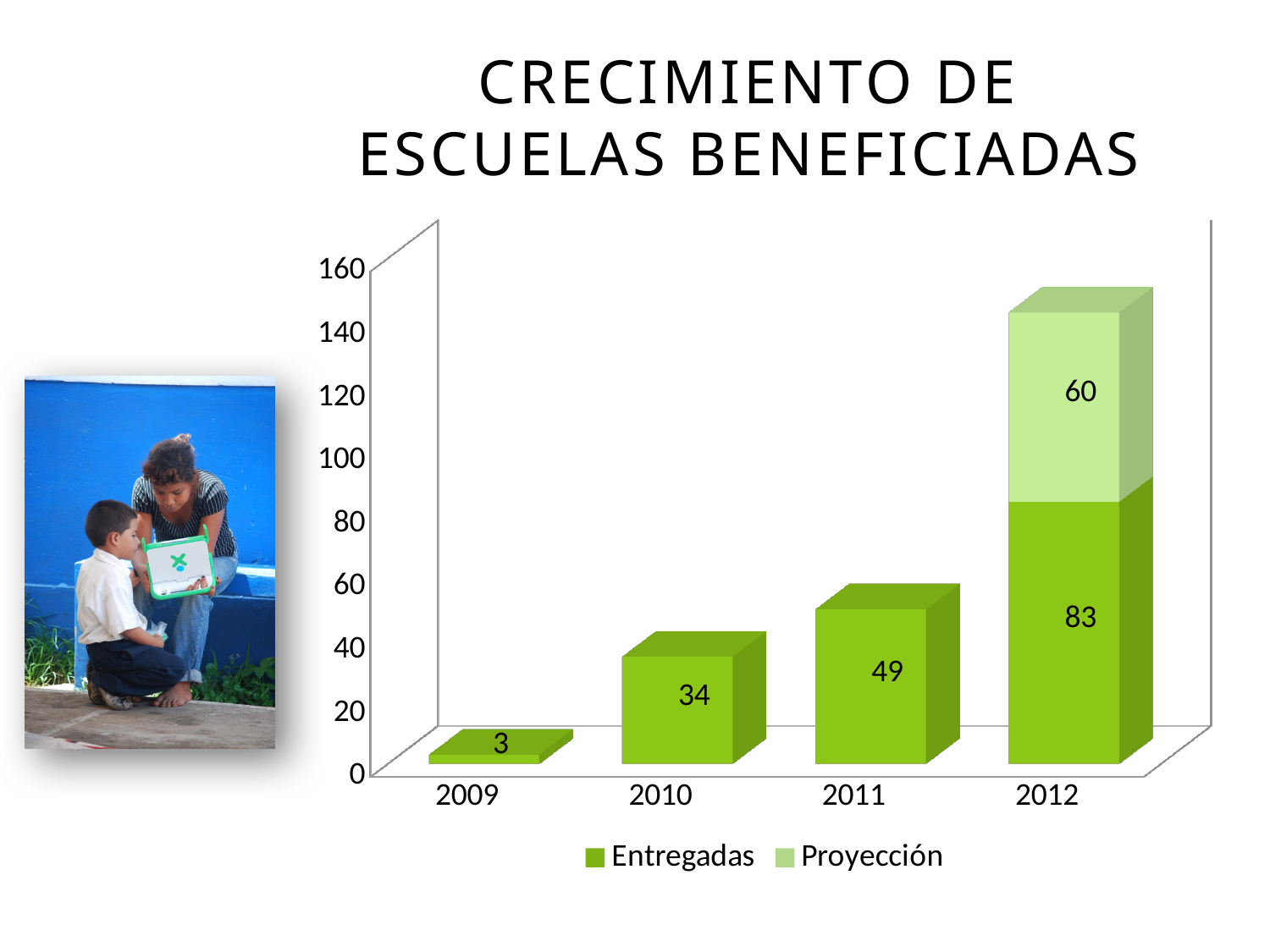
What is the Proyección value for 2012? 60 What is the total of the stacked bar for 2012? 143 Which is larger, the Entregadas value for 2010 or for 2011? 2011 How many years are shown on the x axis? 4 Which year has the highest Entregadas value? 2012 Which year has the lowest Entregadas value? 2009 What is the difference between the Entregadas values for 2012 and 2011? 34 What is the Entregadas value for 2011? 49 How many series does the legend list? 2 What is the Entregadas value for 2009? 3 Do the Entregadas values rise or fall from 2009 to 2012? Rise What kind of chart is shown on the slide? Bar chart